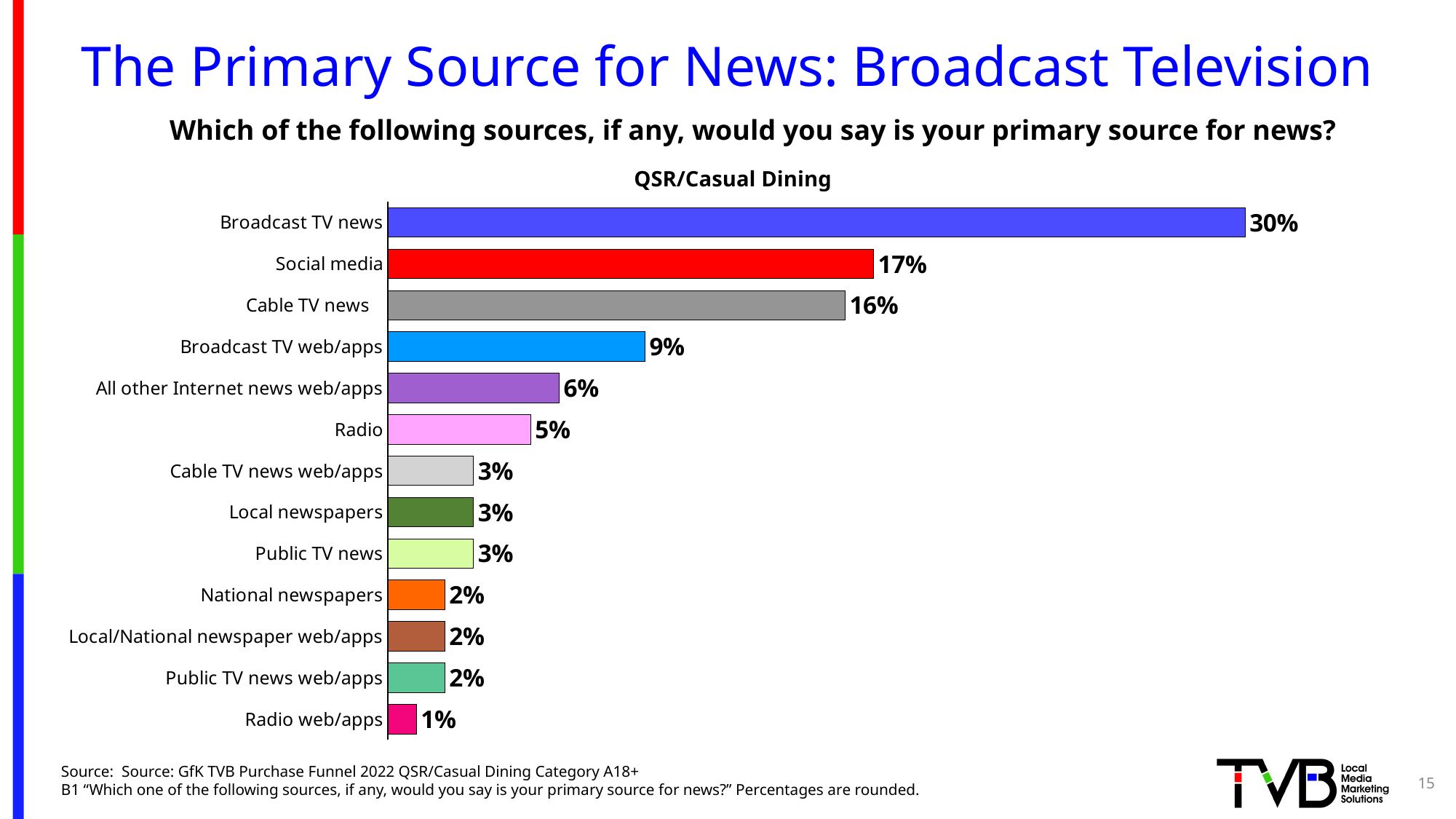
What percentage of respondents named Broadcast TV news as their primary source for news? 30% Which is larger, the value for Cable TV news or the value for All other Internet news web/apps? Cable TV news Which source has the lowest percentage? Radio web/apps What is the difference in percentage points between Social media and Broadcast TV web/apps? 8 How many news sources are shown in the chart? 13 What type of chart is shown on the slide? Bar chart What is the value shown for Radio? 5% What is the title of the chart? QSR/Casual Dining What is the value shown for Social media? 17% What is the value shown for Broadcast TV web/apps? 9% What is the difference in percentage points between Broadcast TV news and Cable TV news? 14 Which source has the highest percentage? Broadcast TV news